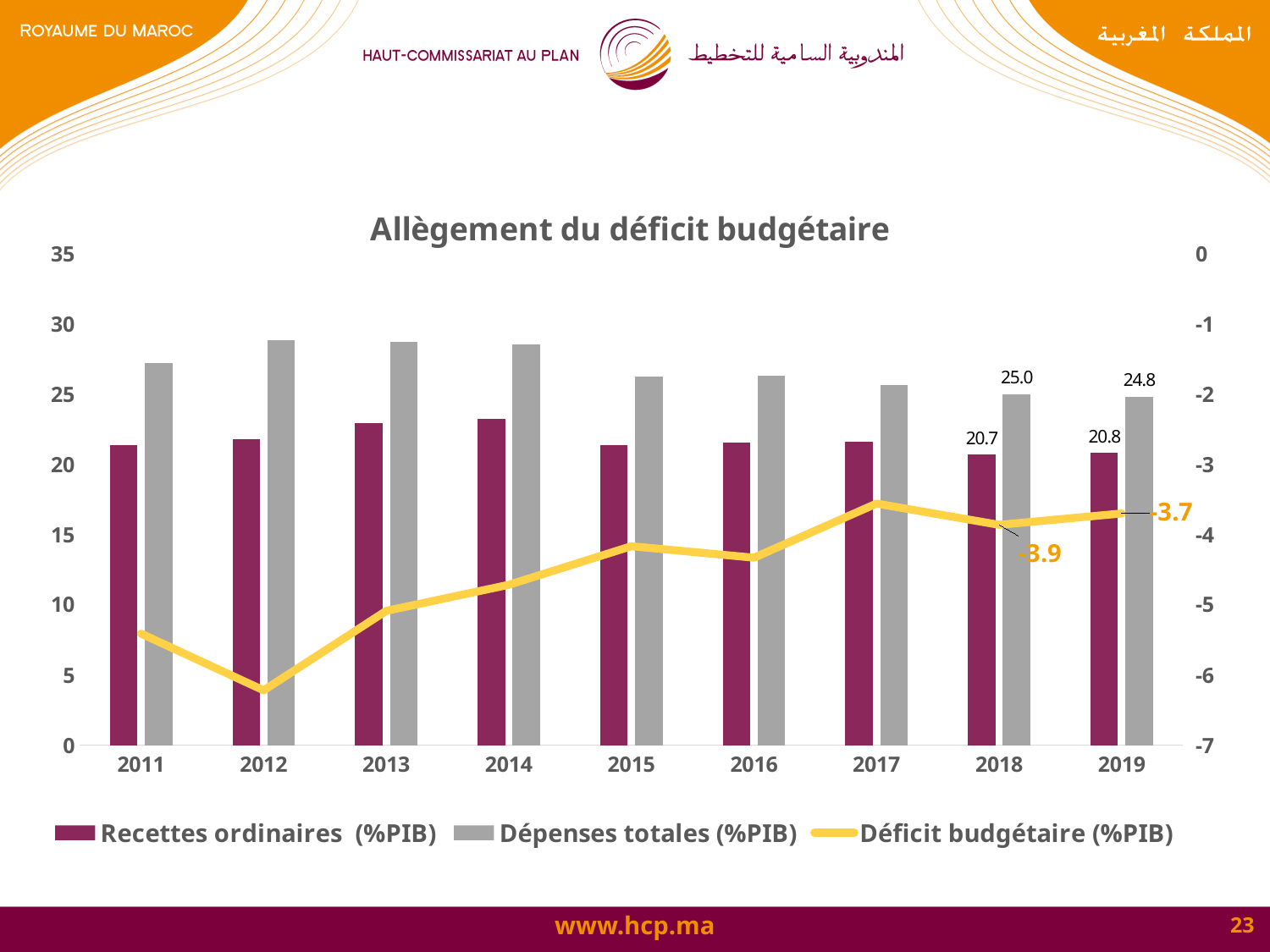
What is the value of Dépenses totales (%PIB) in 2019? 24.8 In which year is the Dépenses totales (%PIB) bar the highest? 2012 What is the value of Déficit budgétaire (%PIB) in 2019? -3.7 What is the difference between Dépenses totales and Recettes ordinaires in 2019? 4.0 In which year is the Déficit budgétaire (%PIB) line at its lowest point? 2012 What is the difference between Dépenses totales and Recettes ordinaires in 2018? 4.3 Which is larger in 2013: Recettes ordinaires or Dépenses totales? Dépenses totales How many years are shown on the x axis? 9 How many series does the legend list? 3 What is the value of Recettes ordinaires (%PIB) in 2018? 20.7 What is the value of Déficit budgétaire (%PIB) in 2018? -3.9 Is the value for Dépenses totales (%PIB) in 2014 greater or less than 25? greater